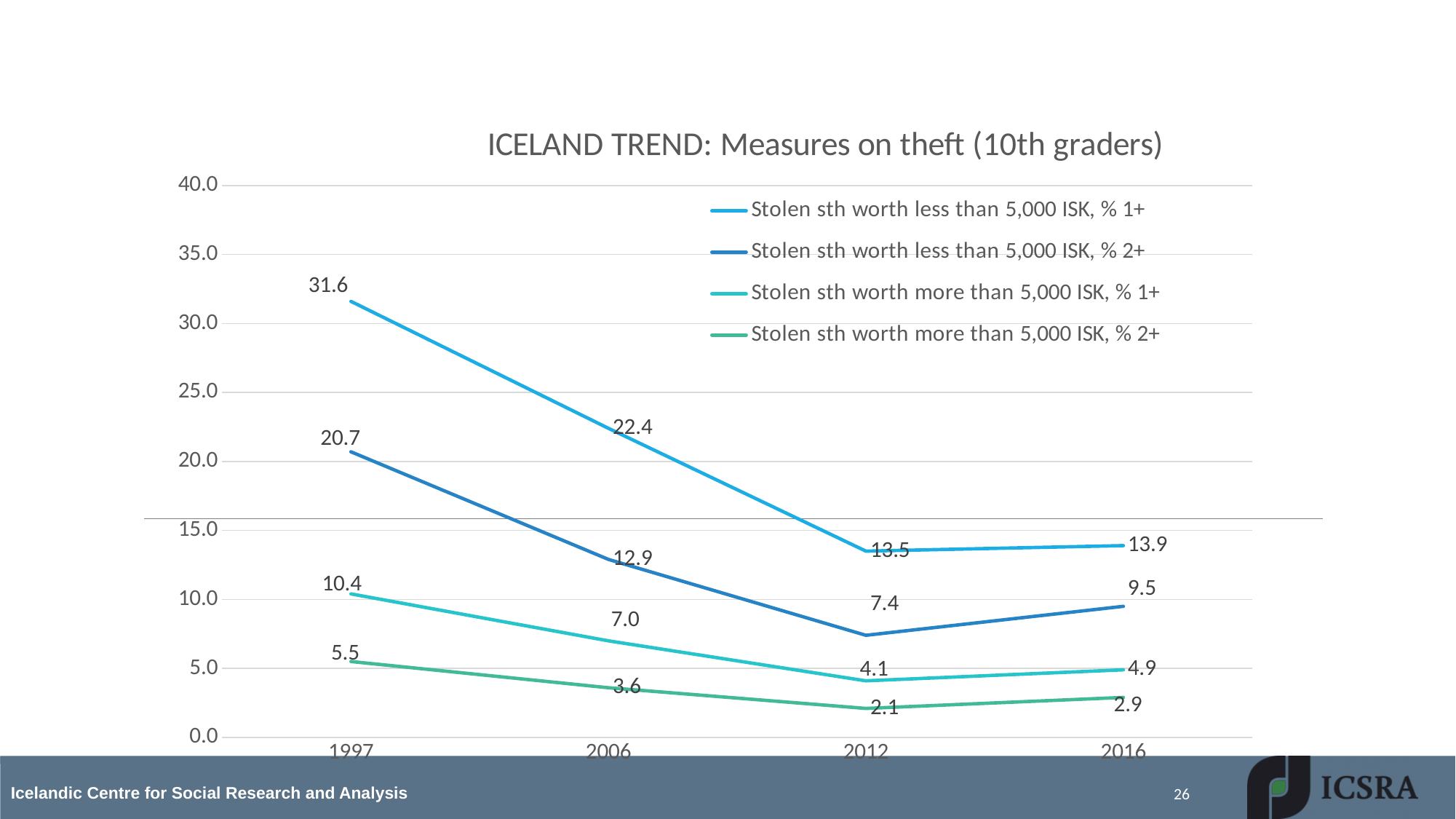
What is the value for 'Stolen sth worth less than 5,000 ISK, % 1+' in 1997? 31.6 What is the value for 'Stolen sth worth less than 5,000 ISK, % 2+' in 2012? 7.4 How many years are shown on the x axis? 4 What is the title of the chart? ICELAND TREND: Measures on theft (10th graders) In which year is the value for 'Stolen sth worth less than 5,000 ISK, % 1+' lowest? 2012 What is the value for 'Stolen sth worth more than 5,000 ISK, % 1+' in 2006? 7.0 How many series does the legend list? 4 Which is larger in 2016: 'Stolen sth worth less than 5,000 ISK, % 2+' or 'Stolen sth worth more than 5,000 ISK, % 1+'? Stolen sth worth less than 5,000 ISK, % 2+ What is the value for 'Stolen sth worth more than 5,000 ISK, % 2+' in 2016? 2.9 What is the difference between the 1997 and 2016 values for 'Stolen sth worth less than 5,000 ISK, % 1+'? 17.7 What type of chart is shown on the slide? Line chart In which year is the value for 'Stolen sth worth more than 5,000 ISK, % 2+' highest? 1997